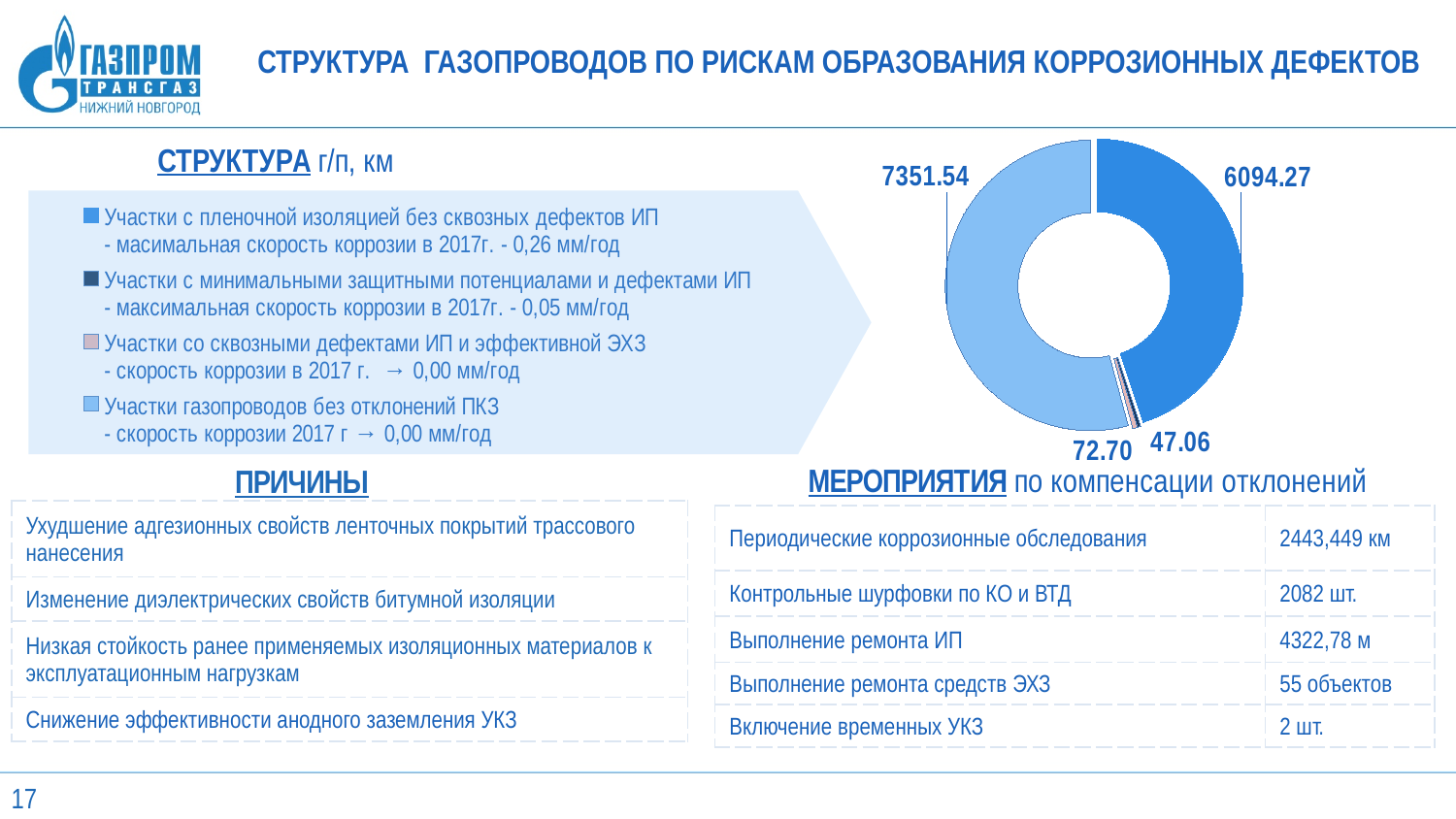
What is the difference between the two smallest values on the donut chart, 72.70 and 47.06? 25.64 What unit is given in the heading above the legend of the donut chart (СТРУКТУРА г/п, ...)? км What is the largest value shown on the donut chart? 7351.54 Which is larger on the donut chart: the light blue slice (7351.54) or the dark blue slice (6094.27)? The light blue slice (7351.54) What is the difference between the two largest values on the donut chart, 7351.54 and 6094.27? 1257.27 What type of chart is shown on the slide? Donut (pie) chart What is the value of the light blue slice (Участки газопроводов без отклонений ПКЗ) on the donut chart? 7351.54 What is the total of all four values shown on the donut chart? 13565.57 What is the smallest value shown on the donut chart? 47.06 How many slices does the donut chart have? 4 How many categories does the legend of the donut chart list? 4 What is the value of the dark blue slice (Участки с пленочной изоляцией без сквозных дефектов ИП) on the donut chart? 6094.27